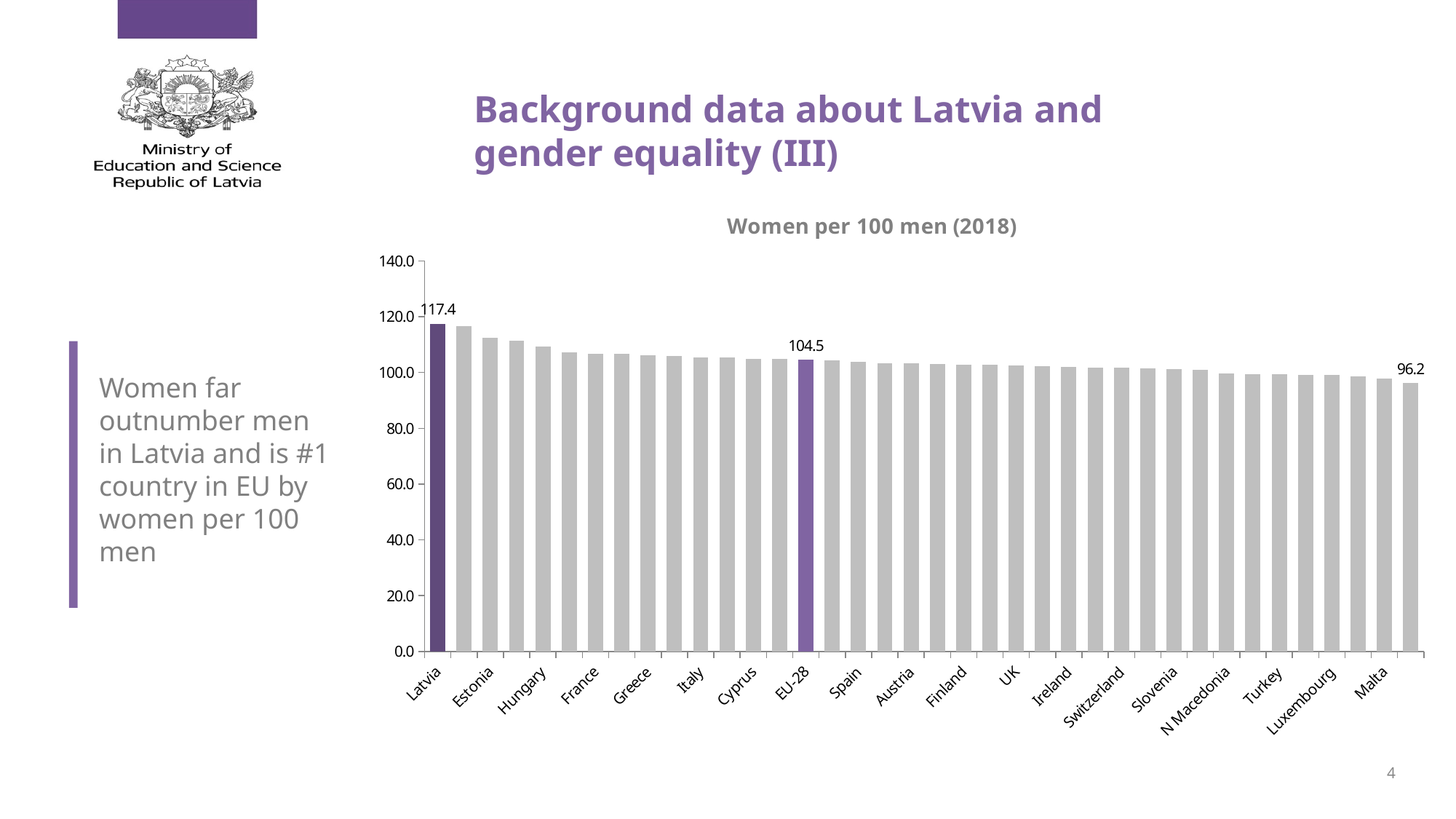
What kind of chart is shown on the slide? bar chart Do the values rise or fall from left to right along the x axis? fall Which category has the highest value in the chart? Latvia What is the difference between the values for Latvia and EU-28? 12.9 What is the value for EU-28 in the chart? 104.5 What is the value for Latvia in the Women per 100 men (2018) chart? 117.4 Which is larger, the value for EU-28 or the value for Malta? EU-28 What is the title of the chart? Women per 100 men (2018) Is the value for Estonia greater or less than 100? greater